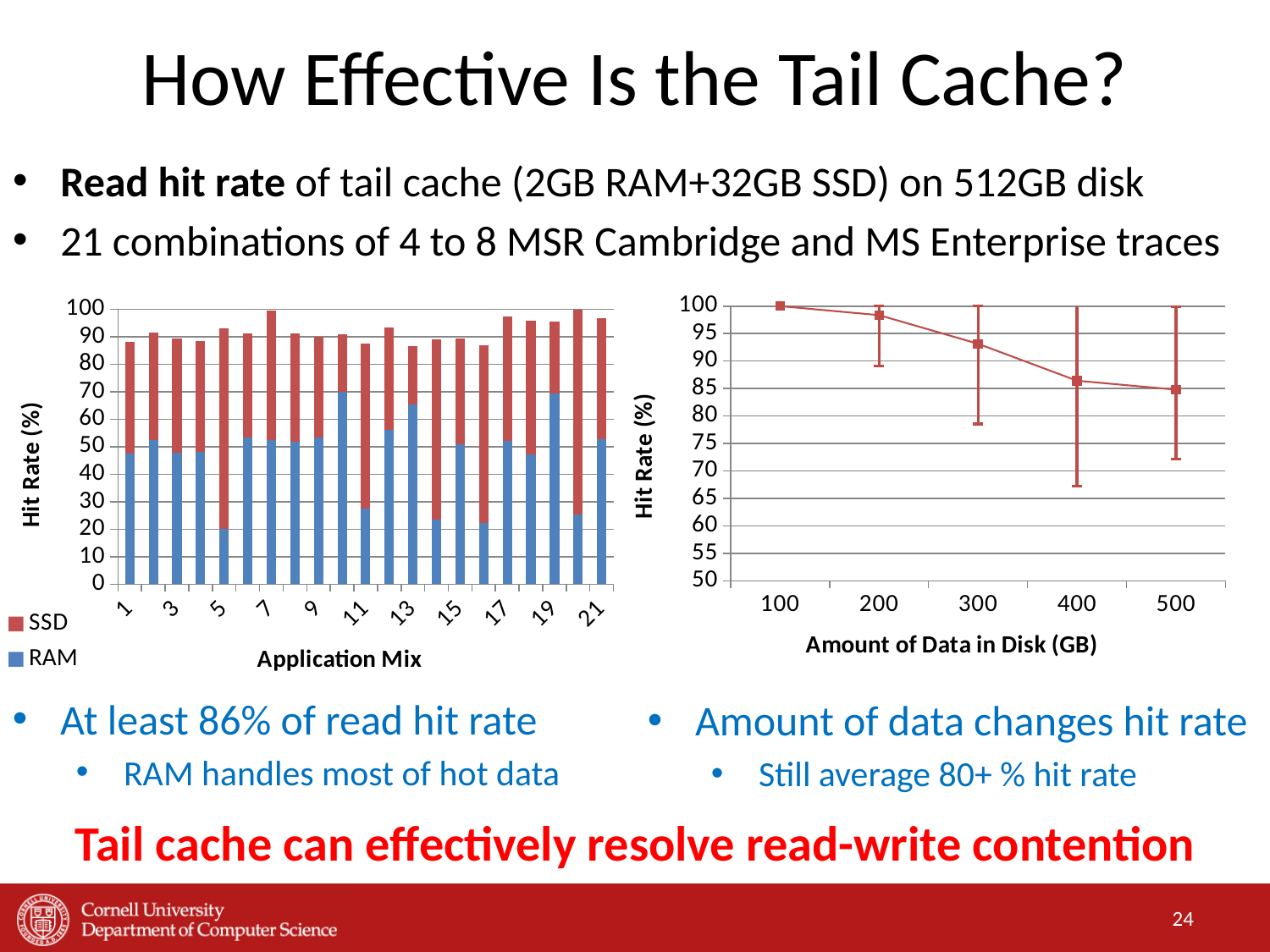
In the right chart, does the hit rate rise or fall as the amount of data in disk increases? fall In the right chart, what is the hit rate at 100 GB of data in disk? 100 In the left chart, is the RAM portion of application mix 11 greater or less than 40? less How many application mixes are plotted on the x axis of the left chart? 21 What is the x-axis title of the right chart? Amount of Data in Disk (GB) What kind of chart is the left chart (Application Mix)? bar chart How many data points are plotted in the right chart? 5 What kind of chart is the right chart (Amount of Data in Disk)? line chart In the left chart, which has the larger RAM portion, application mix 10 or application mix 5? application mix 10 In the right chart, is the hit rate at 300 GB greater or less than 90? greater How many series does the legend of the left chart list? 2 In the right chart, which amount of data in disk has the highest hit rate? 100